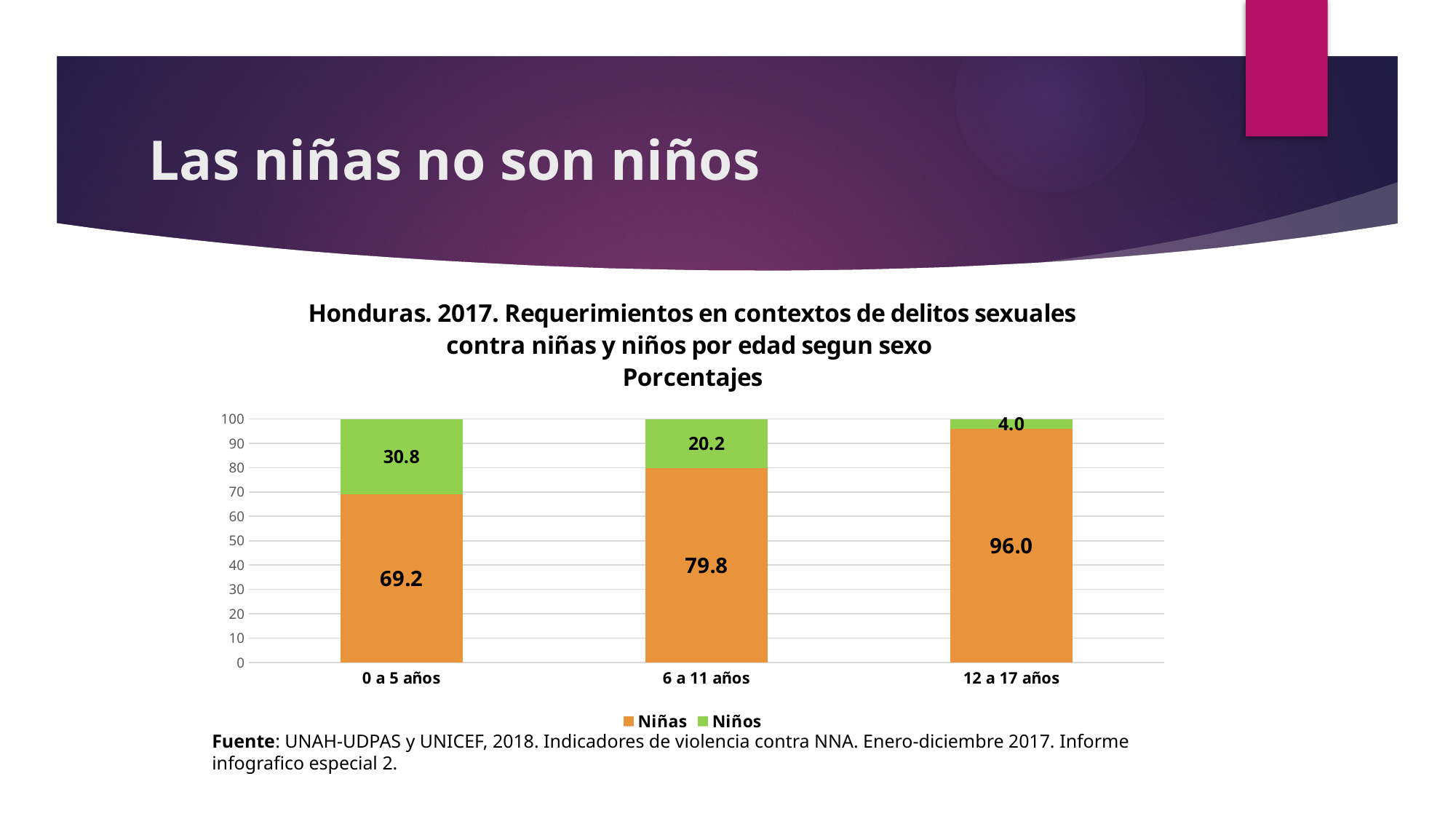
What is the total of the stacked bar for 0 a 5 años? 100 Do the Niñas values rise or fall from 0 a 5 años to 12 a 17 años? Rise Which age group has the lowest value for Niños? 12 a 17 años What is the value for Niños in the 6 a 11 años category? 20.2 What is the difference between the Niñas and Niños values in the 6 a 11 años category? 59.6 How many age categories are shown on the x axis? 3 Which is larger in the 0 a 5 años category, Niñas or Niños? Niñas What kind of chart is shown on the slide? Stacked bar chart What is the value for Niños in the 12 a 17 años category? 4.0 What is the value for Niñas in the 0 a 5 años category? 69.2 Which age group has the highest value for Niñas? 12 a 17 años How many series does the legend list? 2